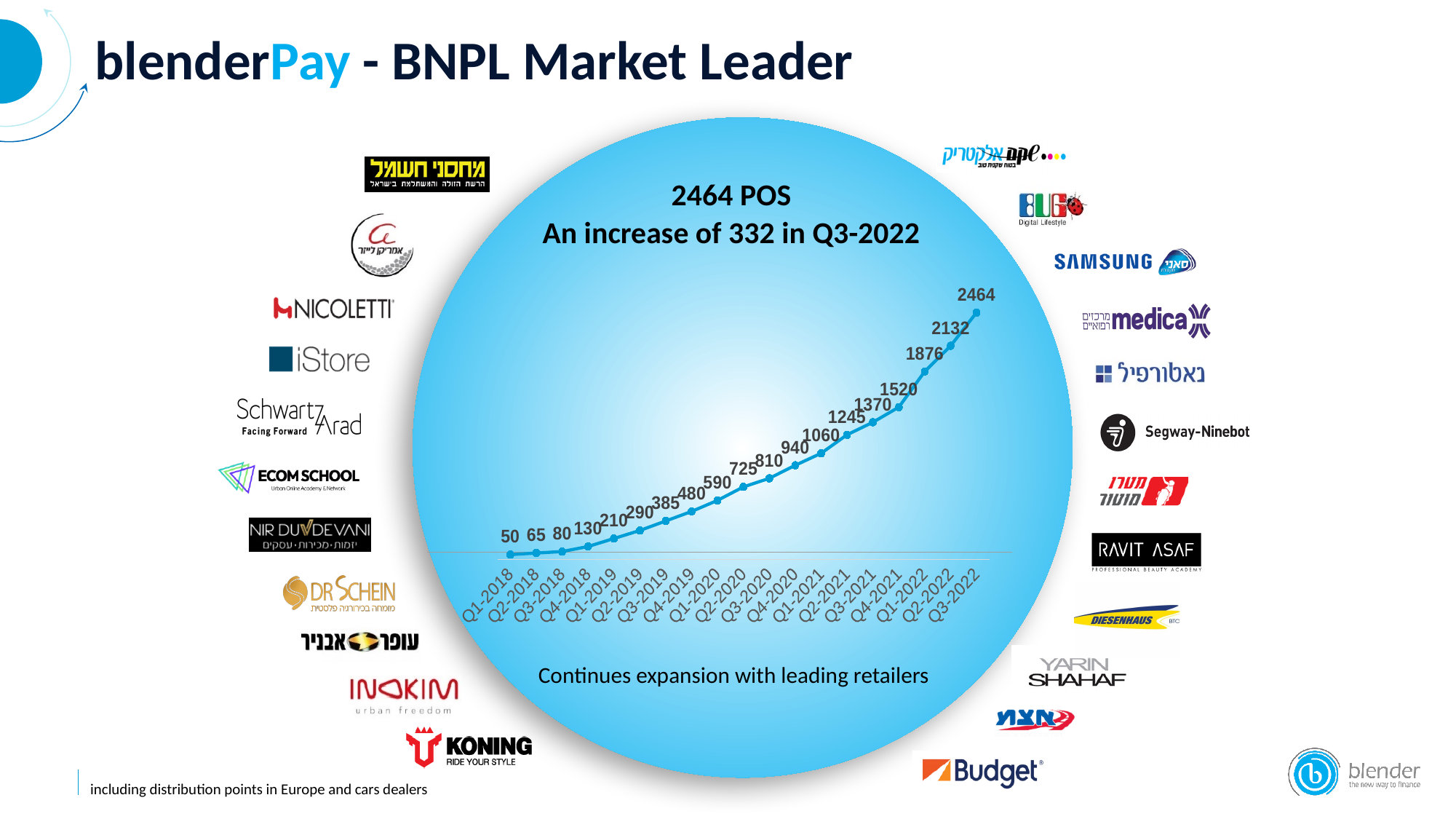
What is the difference between the values for Q1-2022 and Q4-2021? 356 Which quarter has the highest value? Q3-2022 What kind of chart is shown? line chart How many quarters are plotted on the chart? 19 What is the value for Q1-2018? 50 What is the value for Q2-2021? 1245 Do the values rise or fall from Q1-2018 to Q3-2022? rise What is the value for Q4-2020? 940 Which is larger, the value for Q3-2019 or the value for Q1-2020? Q1-2020 What is the difference between the values for Q3-2022 and Q2-2022? 332 Which quarter has the lowest value? Q1-2018 What is the value for Q3-2022? 2464